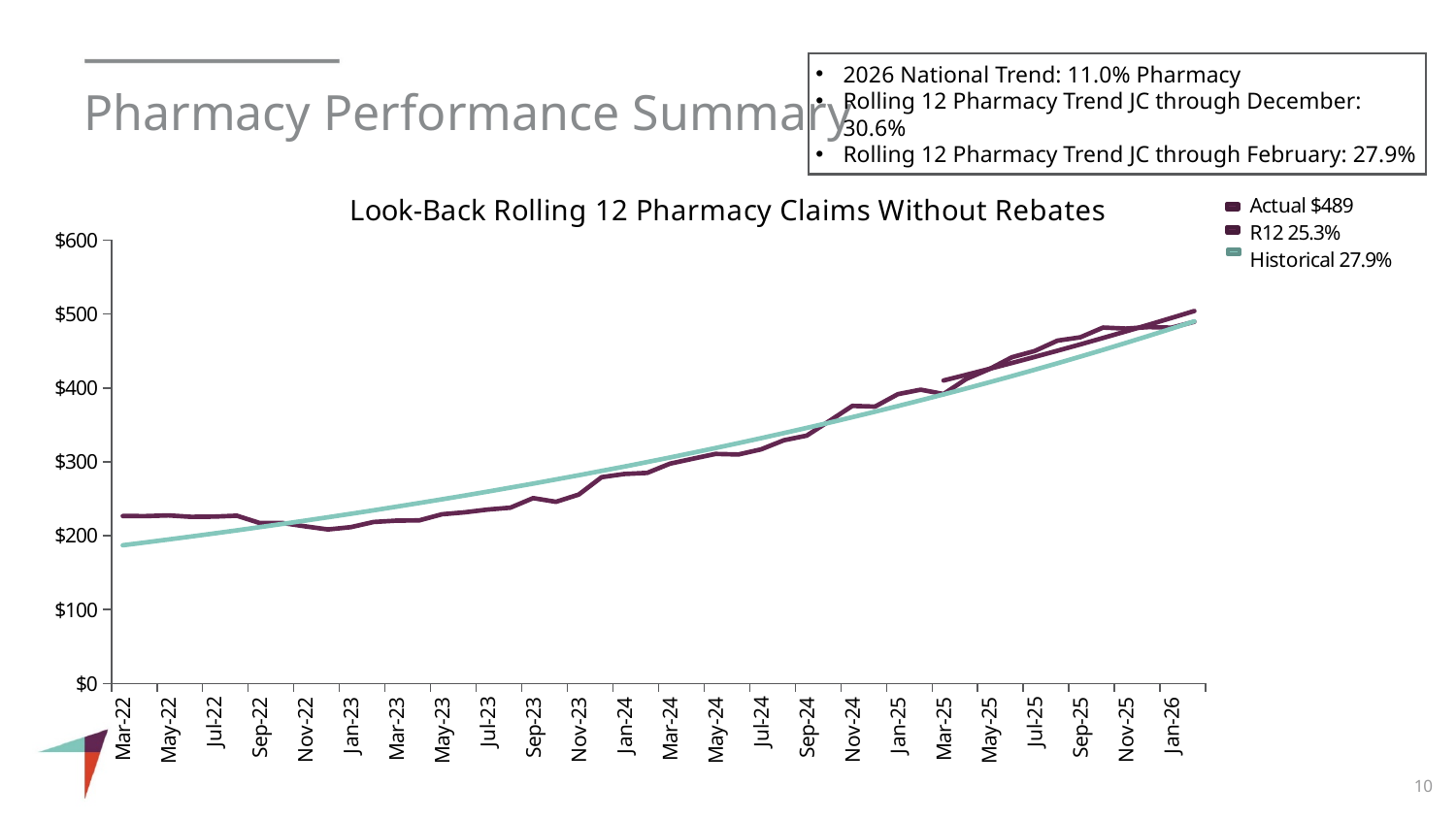
What type of chart is shown on the slide? line chart Is the Actual value at Nov-22 greater or less than $300? less Is the Actual value at Jan-26 greater or less than $400? greater What percentage is shown next to "R12" in the chart legend? 25.3% Is the Actual value at Mar-22 greater or less than $200? greater What is the title of the chart? Look-Back Rolling 12 Pharmacy Claims Without Rebates How many series does the chart legend list? 3 What value is shown next to "Actual" in the chart legend? $489 What is the highest value shown on the y axis? $600 Does the Actual line generally rise or fall from Mar-22 to Jan-26? rise What percentage is shown next to "Historical" in the chart legend? 27.9%